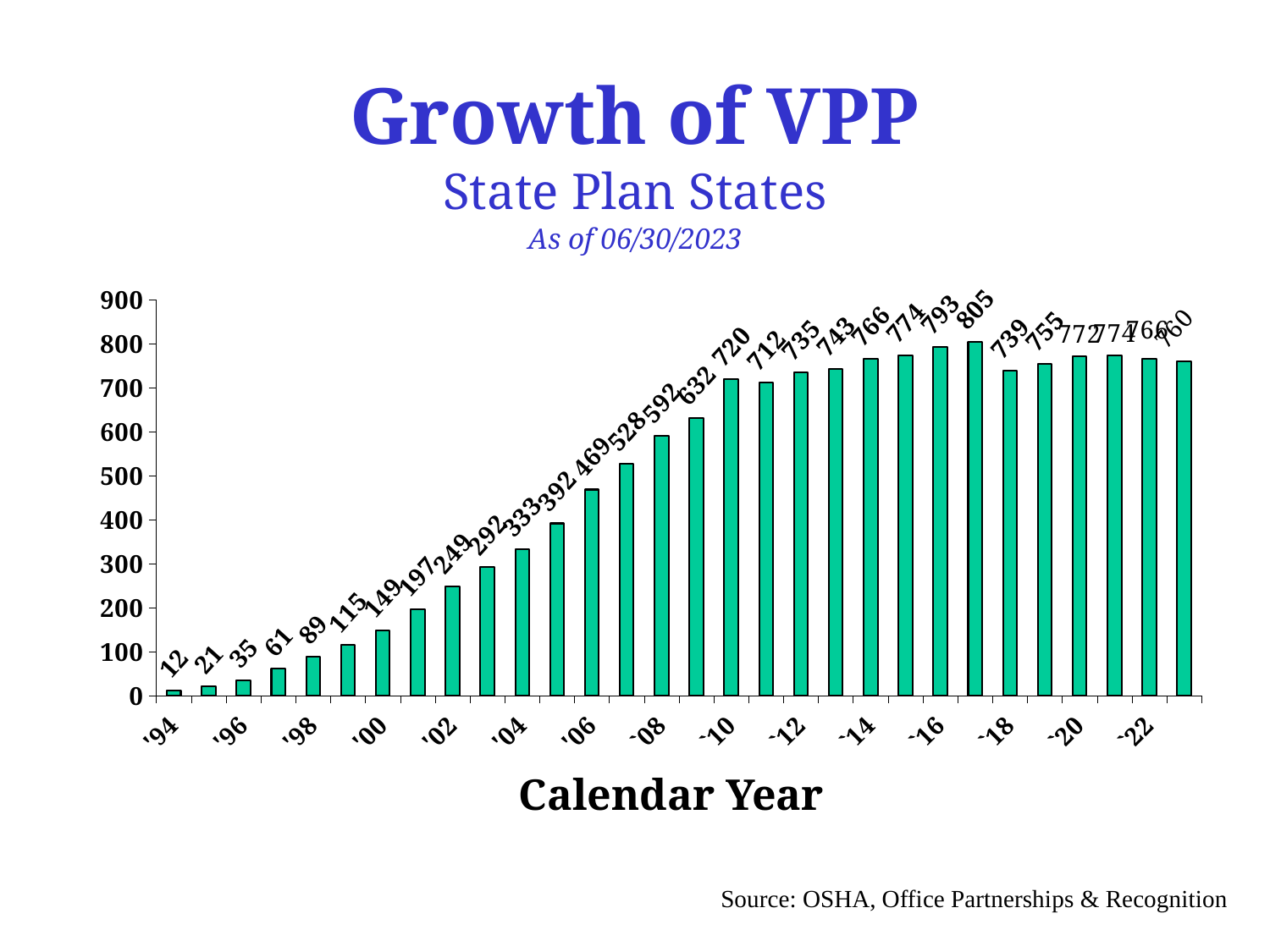
What is the value for '10? 720 Which year has the lowest value? '94 Which is larger, the value for '08 or the value for '14? '14 Is the value for '06 greater or less than 400? greater What is the difference between the values for '10 and '00? 571 What is the value for '16? 793 What is the value for '94? 12 What kind of chart is shown on the slide? bar chart How many bars are plotted on the chart? 30 What is the title of the x axis? Calendar Year What is the value for '00? 149 What is the highest value shown on the chart? 805